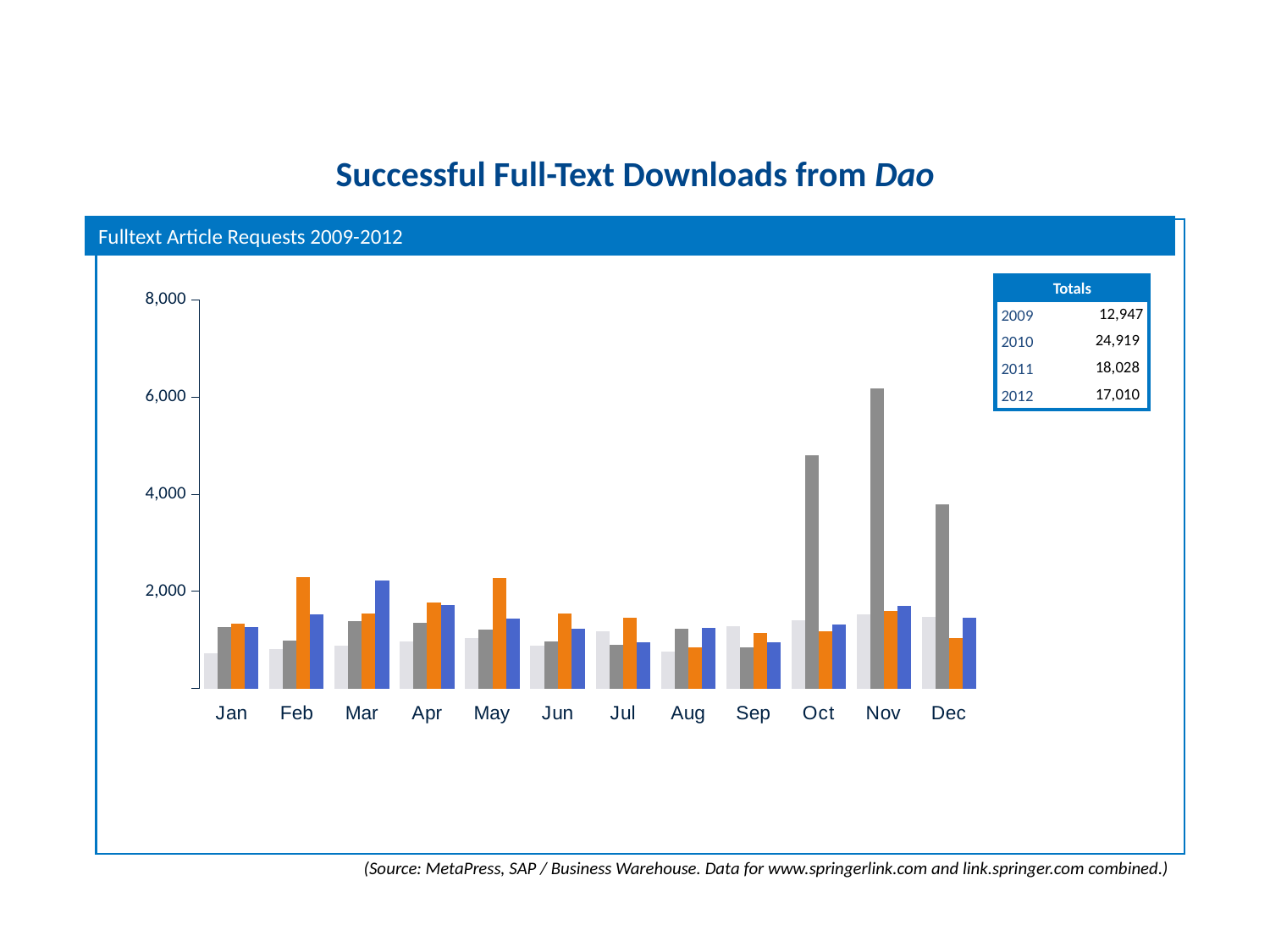
According to the Totals table, what is the total for 2009? 12,947 Which month contains the tallest bar in the chart? Nov What is the difference between the 2010 and 2011 totals in the Totals table? 6,891 What kind of chart is shown on the slide? bar chart Is the tallest bar in Nov greater or less than 6,000? greater In the Totals table, which is larger, the total for 2011 or the total for 2012? 2011 Is the tallest bar in Oct greater or less than 4,000? greater According to the Totals table, what is the total for 2010? 24,919 What is the title shown in the header bar of the chart? Fulltext Article Requests 2009-2012 How many months are shown along the x axis of the chart? 12 Which year has the lowest value in the Totals table? 2009 Which year has the highest value in the Totals table? 2010